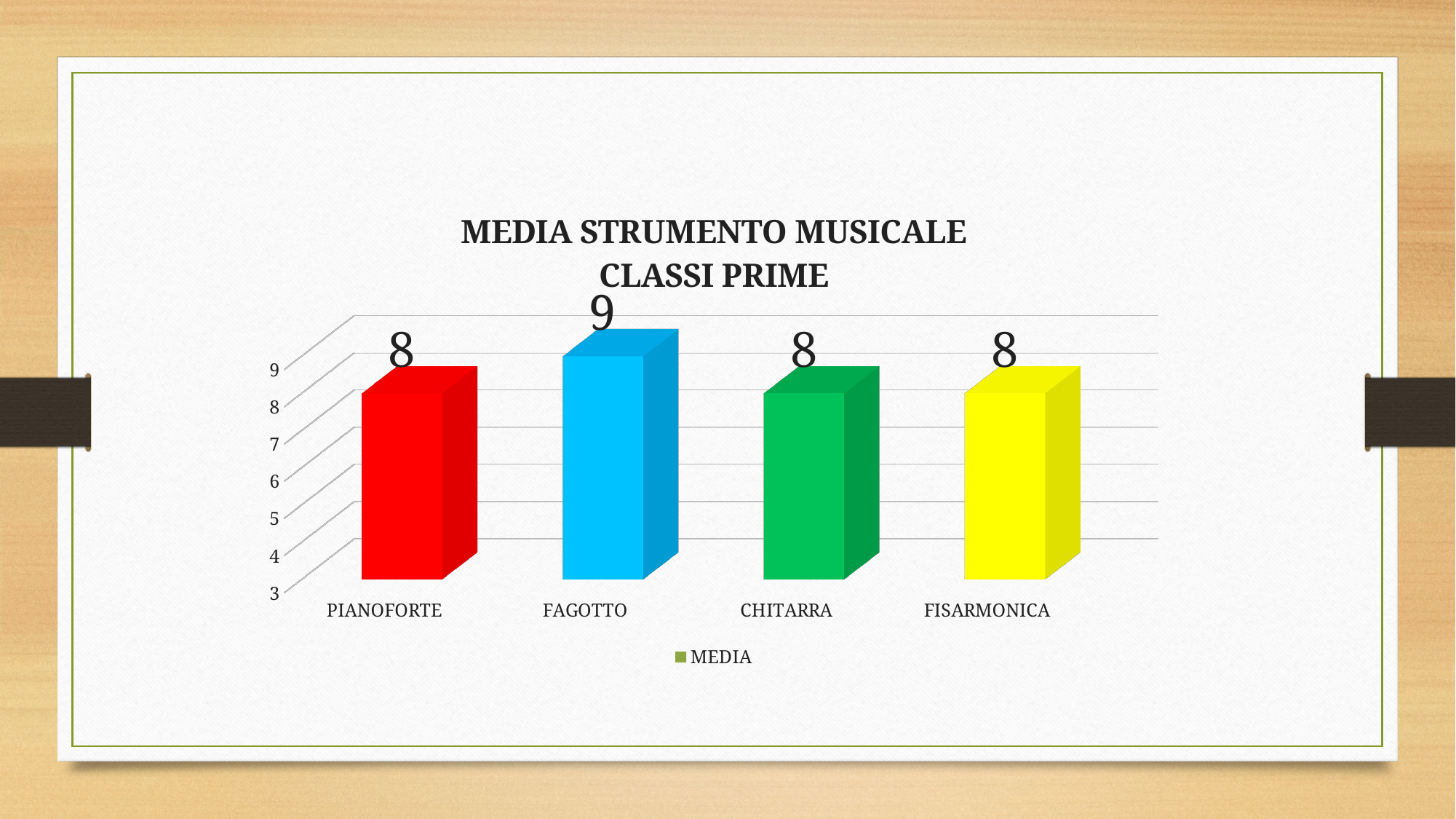
How many instruments are shown on the x axis? 4 What is the value for FAGOTTO? 9 What is the value for CHITARRA? 8 What kind of chart is shown? bar chart What is the value for FISARMONICA? 8 Which is larger, the value for FAGOTTO or the value for PIANOFORTE? FAGOTTO What is the difference between the values for FAGOTTO and CHITARRA? 1 Which instrument has the highest value? FAGOTTO What is the title of the chart? MEDIA STRUMENTO MUSICALE CLASSI PRIME What is the name of the series listed in the legend? MEDIA What is the value for PIANOFORTE? 8 How many series does the legend list? 1